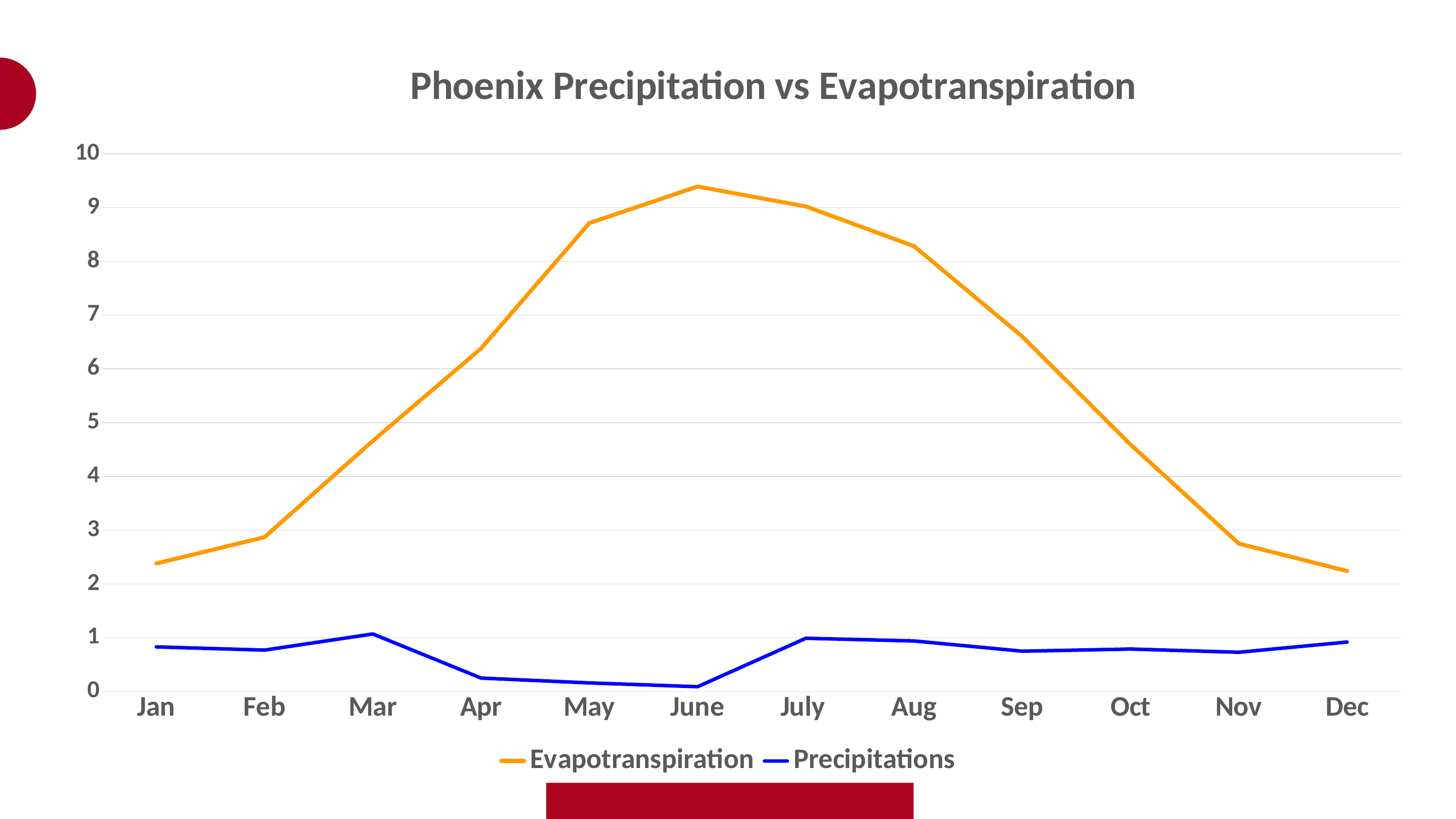
What colour is the Precipitations line? blue Is the Evapotranspiration value for Jan greater or less than 3? less Is the Precipitations value for Apr greater or less than 1? less Which is larger in June, Evapotranspiration or Precipitations? Evapotranspiration How many months are plotted along the x axis? 12 How many series does the legend list? 2 Is the Evapotranspiration value for June greater or less than 9? greater Does Evapotranspiration rise or fall from Jan to June? rise What type of chart is shown on the slide? line chart Which is larger for Evapotranspiration, May or Nov? May In which month does Evapotranspiration reach its highest value? June